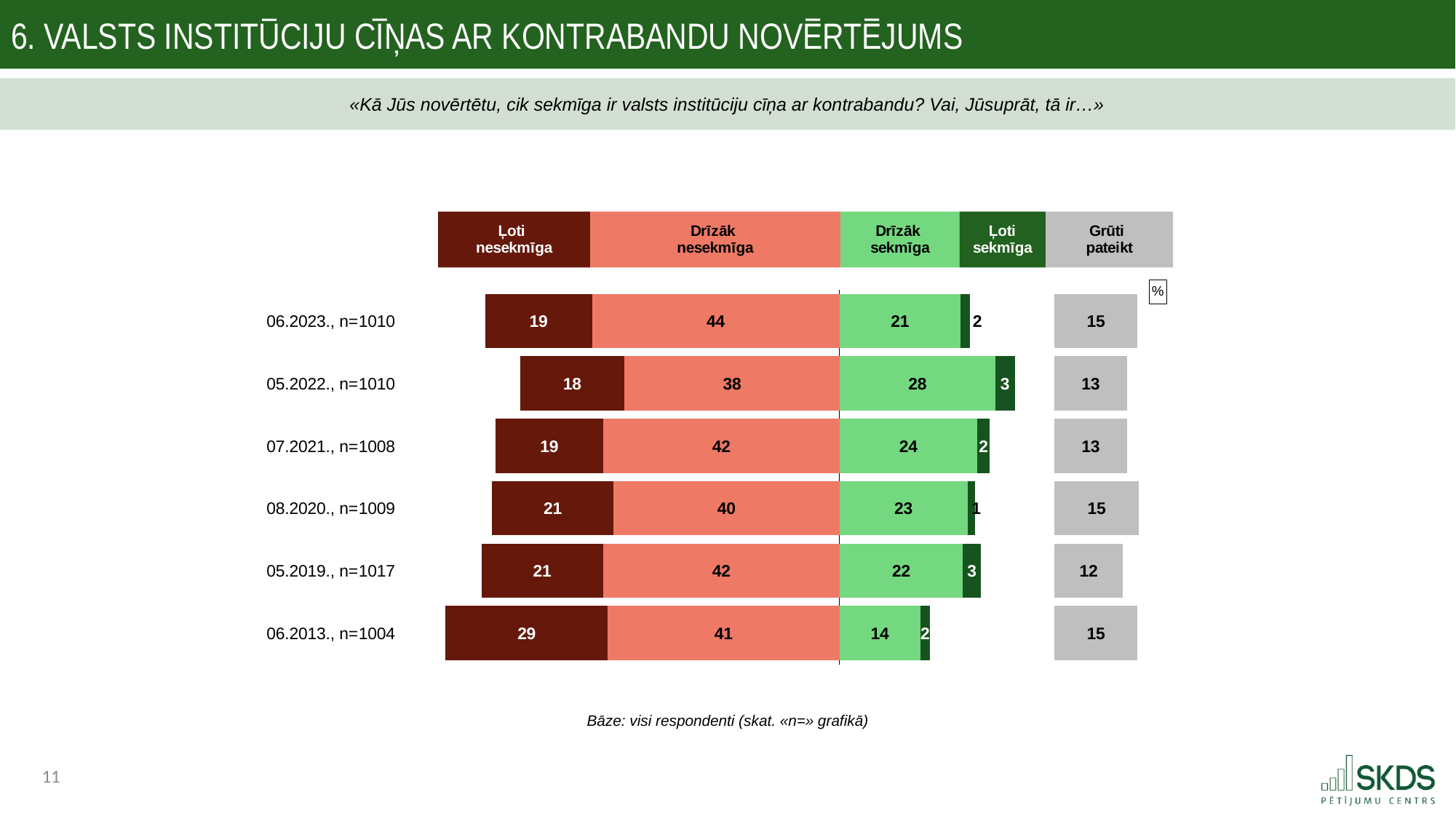
How many survey waves are shown in the chart? 6 Which is larger: the "Drīzāk sekmīga" value for 07.2021., n=1008 or for 08.2020., n=1009? 07.2021., n=1008 What is the "Grūti pateikt" value for 05.2019., n=1017? 12 What type of chart is shown on the slide? Stacked bar chart What percentage of respondents answered "Drīzāk nesekmīga" in 06.2023., n=1010? 44 What is the "Drīzāk sekmīga" value for 05.2022., n=1010? 28 What is the difference between the "Drīzāk nesekmīga" values for 06.2023., n=1010 and 05.2022., n=1010? 6 Which survey wave has the highest "Ļoti nesekmīga" value? 06.2013., n=1004 What is the total of the "Ļoti nesekmīga" and "Drīzāk nesekmīga" values for 08.2020., n=1009? 61 How many response categories does the legend list? 5 Which survey wave has the lowest "Drīzāk sekmīga" value? 06.2013., n=1004 What is the value for "Ļoti nesekmīga" in 06.2013., n=1004? 29